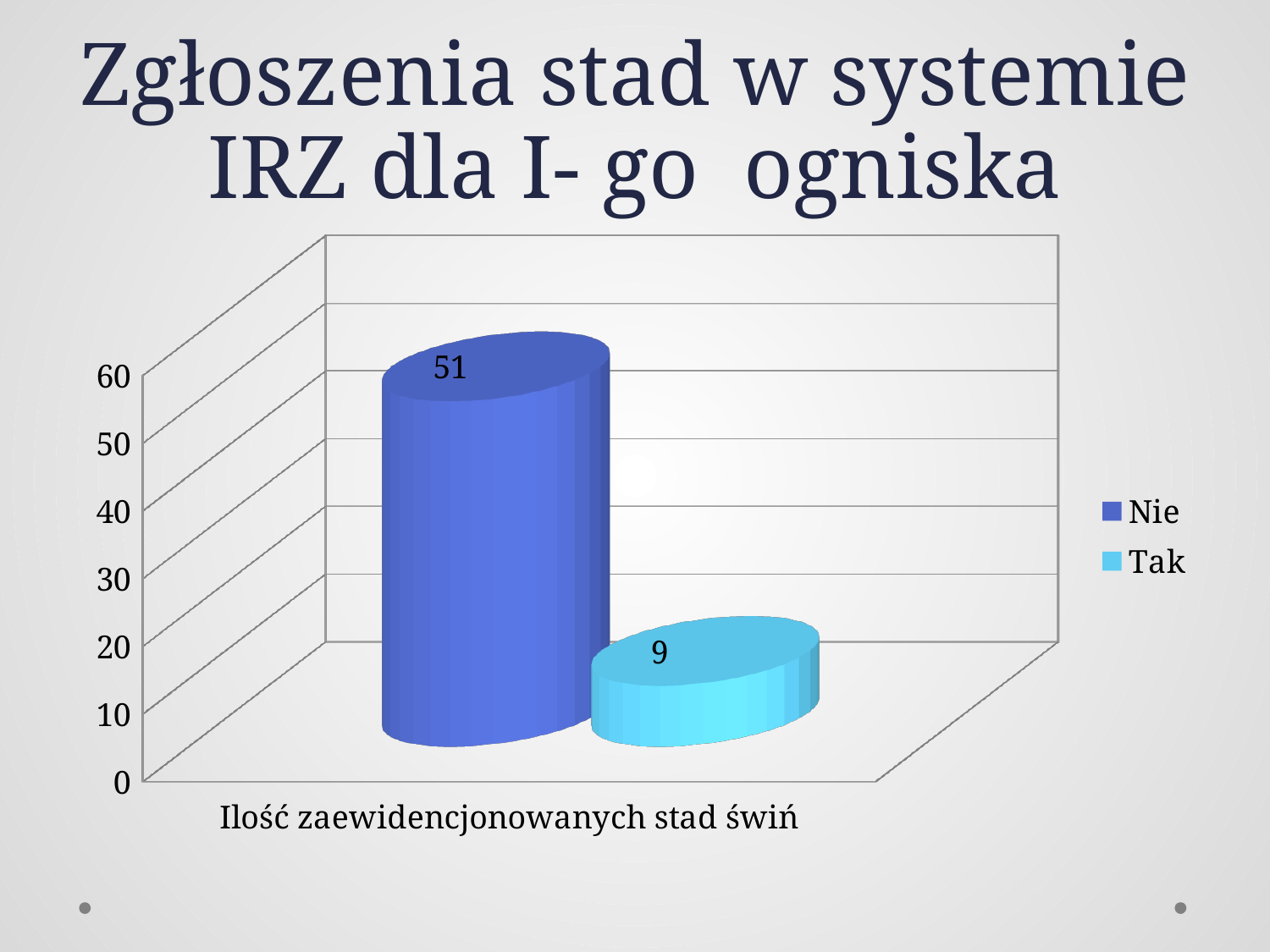
What is the category label shown below the bars? Ilość zaewidencjonowanych stad świń What kind of chart is shown on the slide? bar chart Is the value for "Tak" greater or less than 20? less What is the difference between the values for "Nie" and "Tak"? 42 What is the value for "Tak"? 9 What is the value for "Nie"? 51 Is the value for "Nie" greater or less than 40? greater What is the total of the two values shown in the chart? 60 Which series has the lower value? Tak How many series does the legend list? 2 Is the value for "Nie" larger or smaller than the value for "Tak"? larger Which series has the higher value, "Nie" or "Tak"? Nie